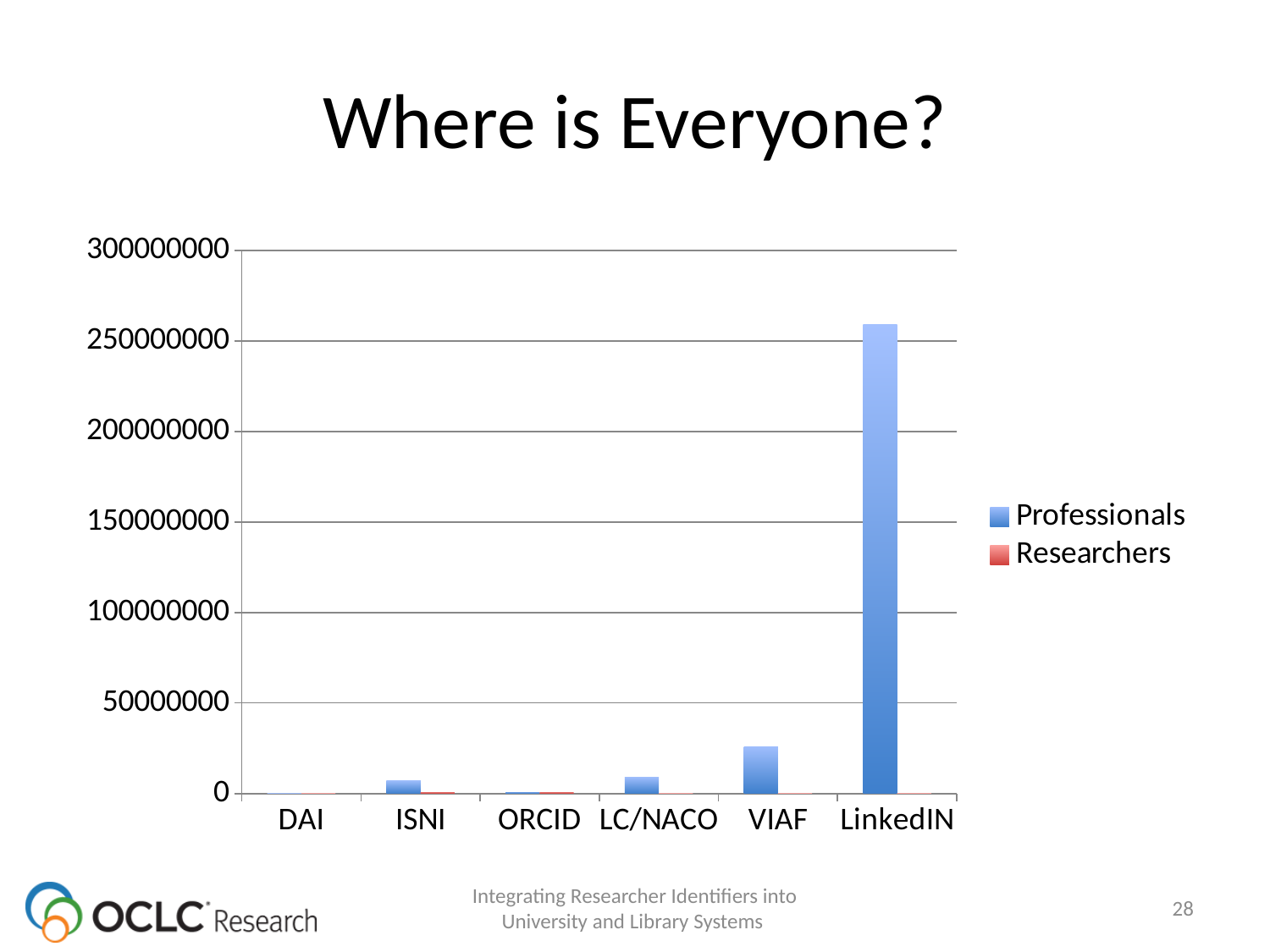
Which category has the highest Professionals value? LinkedIN Is the Professionals value for LinkedIN greater or less than 250000000? greater Which category is listed first on the x axis? DAI What is the title of the chart? Where is Everyone? Is the Professionals value for LinkedIN greater or less than 300000000? less Which has a larger Professionals value, VIAF or ISNI? VIAF How many categories are shown on the x axis? 6 What kind of chart is shown on the slide? bar chart Which series is shown in blue? Professionals Is the Professionals value for VIAF greater or less than 50000000? less How many series does the legend list? 2 Which has a larger Professionals value, LinkedIN or VIAF? LinkedIN